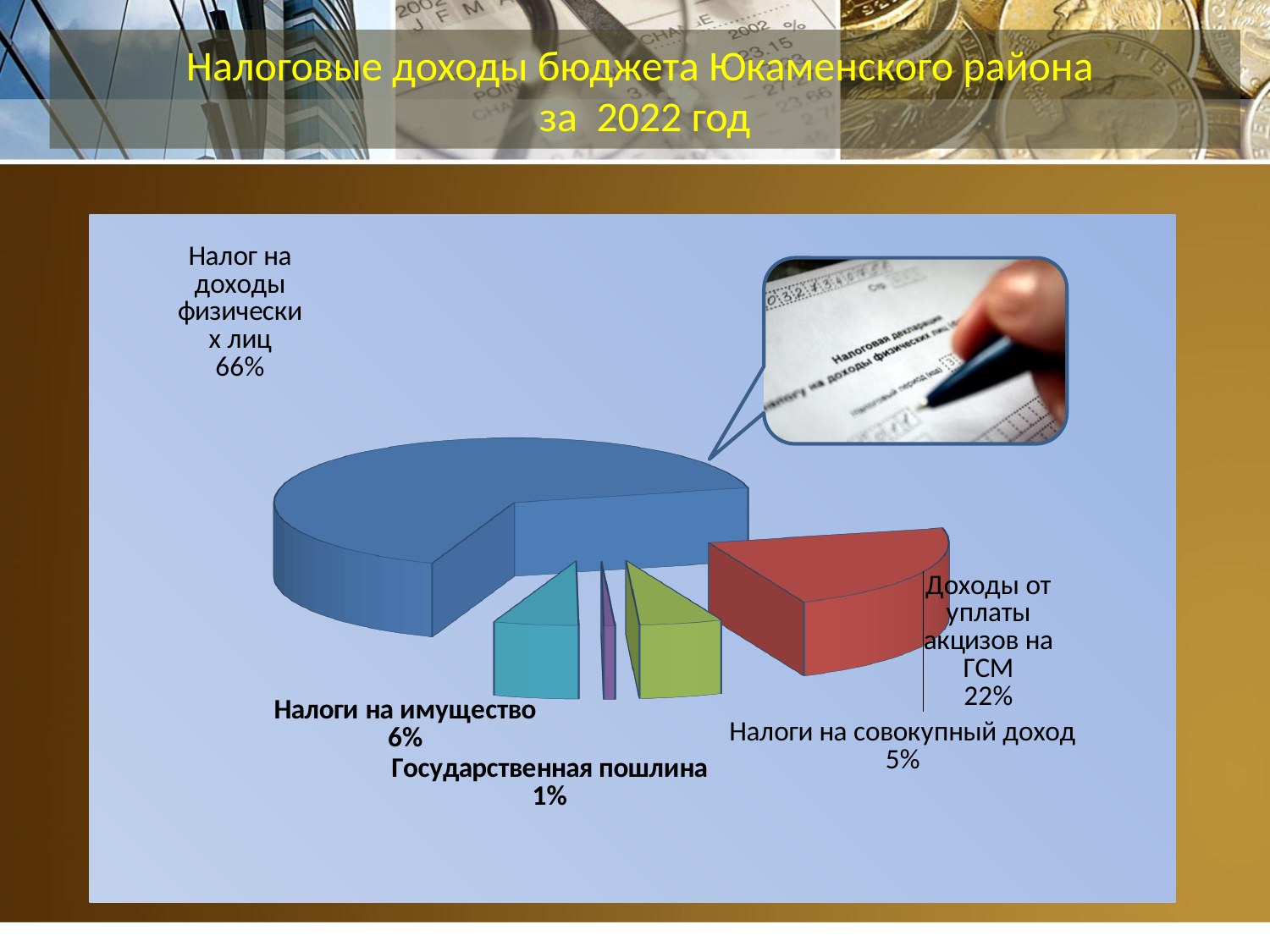
What is the value shown for "Налоги на совокупный доход"? 5% What is the difference between the shares of "Налог на доходы физических лиц" and "Доходы от уплаты акцизов на ГСМ"? 44% Which category has the smallest share of the pie? Государственная пошлина What is the title of the slide? Налоговые доходы бюджета Юкаменского района за 2022 год What share of the pie does "Налог на доходы физических лиц" account for? 66% How many slices does the pie chart have? 5 What is the value shown for "Налоги на имущество"? 6% What is the value shown for "Доходы от уплаты акцизов на ГСМ"? 22% What is the value shown for "Государственная пошлина"? 1% Which category has the largest share of the pie? Налог на доходы физических лиц Which is larger: "Налоги на имущество" or "Налоги на совокупный доход"? Налоги на имущество What kind of chart is shown on the slide? Pie chart